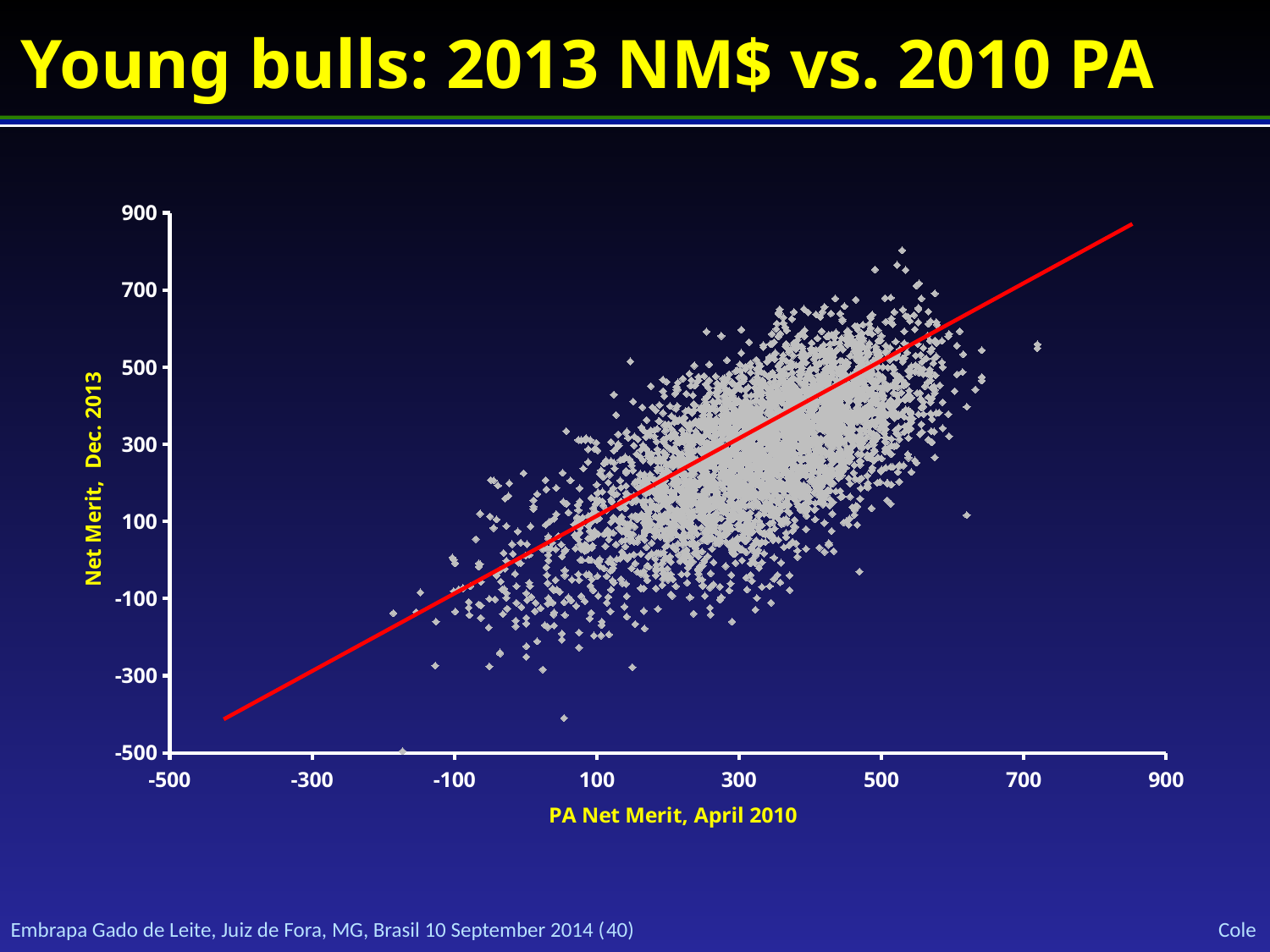
Is the highest Net Merit, Dec. 2013 value plotted greater or less than 700? greater Do the Net Merit, Dec. 2013 values tend to rise or fall as PA Net Merit, April 2010 increases? rise Is the largest PA Net Merit, April 2010 value plotted greater or less than 500? greater What is the highest value shown on the y axis? 900 Does the red trend line slope upward or downward from left to right? upward What kind of chart is shown on the slide? scatter chart What is the label of the x axis? PA Net Merit, April 2010 What is the lowest value shown on the x axis? -500 Is the smallest PA Net Merit, April 2010 value plotted greater or less than -100? less What is the title of the chart on the slide? Young bulls: 2013 NM$ vs. 2010 PA